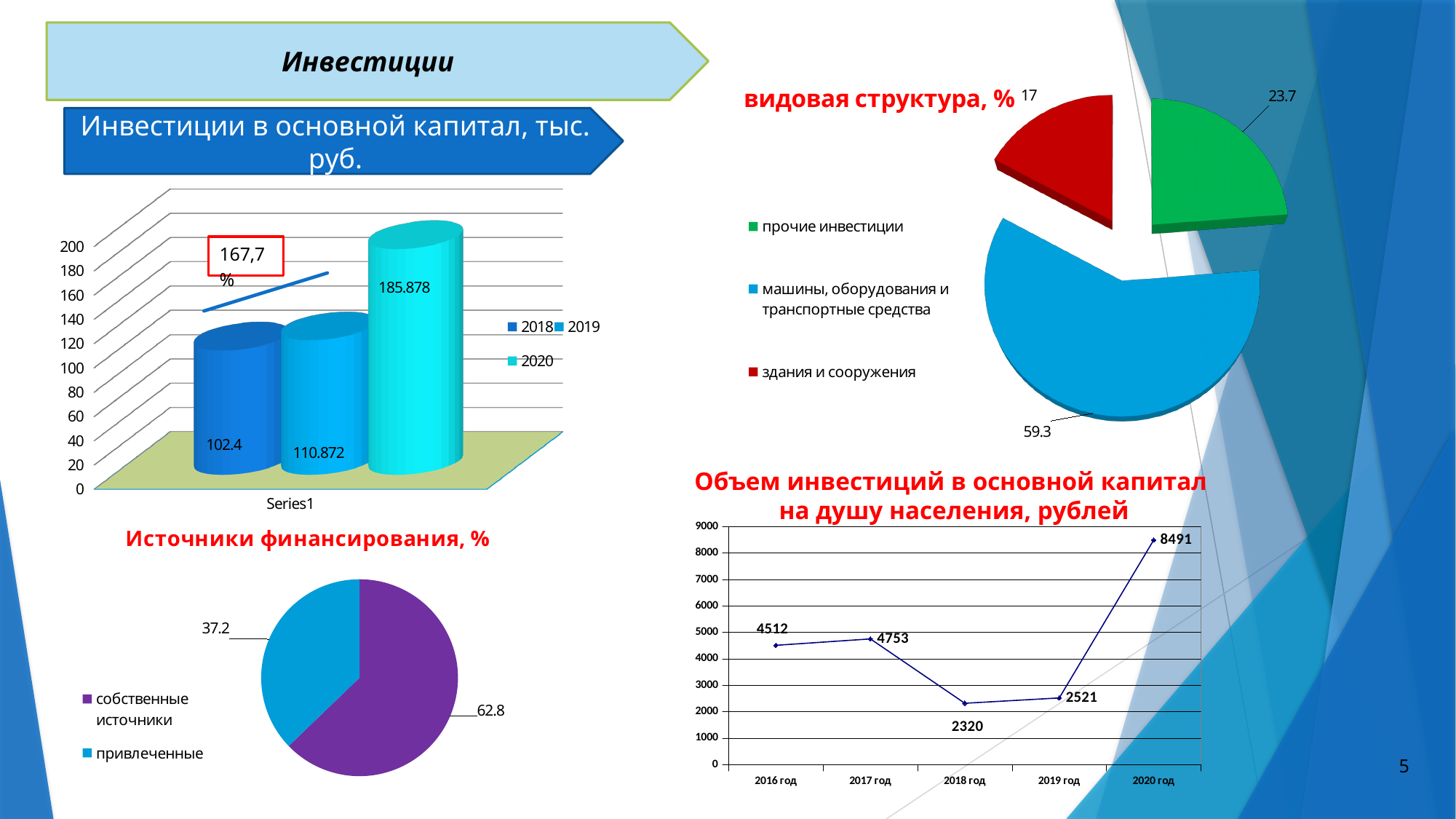
In the chart 'видовая структура, %', what is the value for 'прочие инвестиции'? 23.7 What kind of chart is 'Источники финансирования, %'? pie chart In the chart 'Объем инвестиций в основной капитал на душу населения, рублей', how many years are plotted on the x axis? 5 In the chart 'Источники финансирования, %', what is the value for 'собственные источники'? 62.8 In the chart 'Объем инвестиций в основной капитал на душу населения, рублей', what is the difference between the values for 2020 год and 2019 год? 5970 In the chart 'Инвестиции в основной капитал, тыс. руб.', what is the value for 2018? 102.4 In the chart 'Инвестиции в основной капитал, тыс. руб.', what is the value for 2020? 185.878 In the chart 'Инвестиции в основной капитал, тыс. руб.', how many series does the legend list? 3 In the chart 'Объем инвестиций в основной капитал на душу населения, рублей', what is the value for 2018 год? 2320 In the chart 'видовая структура, %', which category has the smallest slice? здания и сооружения In the chart 'Инвестиции в основной капитал, тыс. руб.', which year has the lowest value? 2018 In the chart 'видовая структура, %', what is the share for 'машины, оборудования и транспортные средства'? 59.3